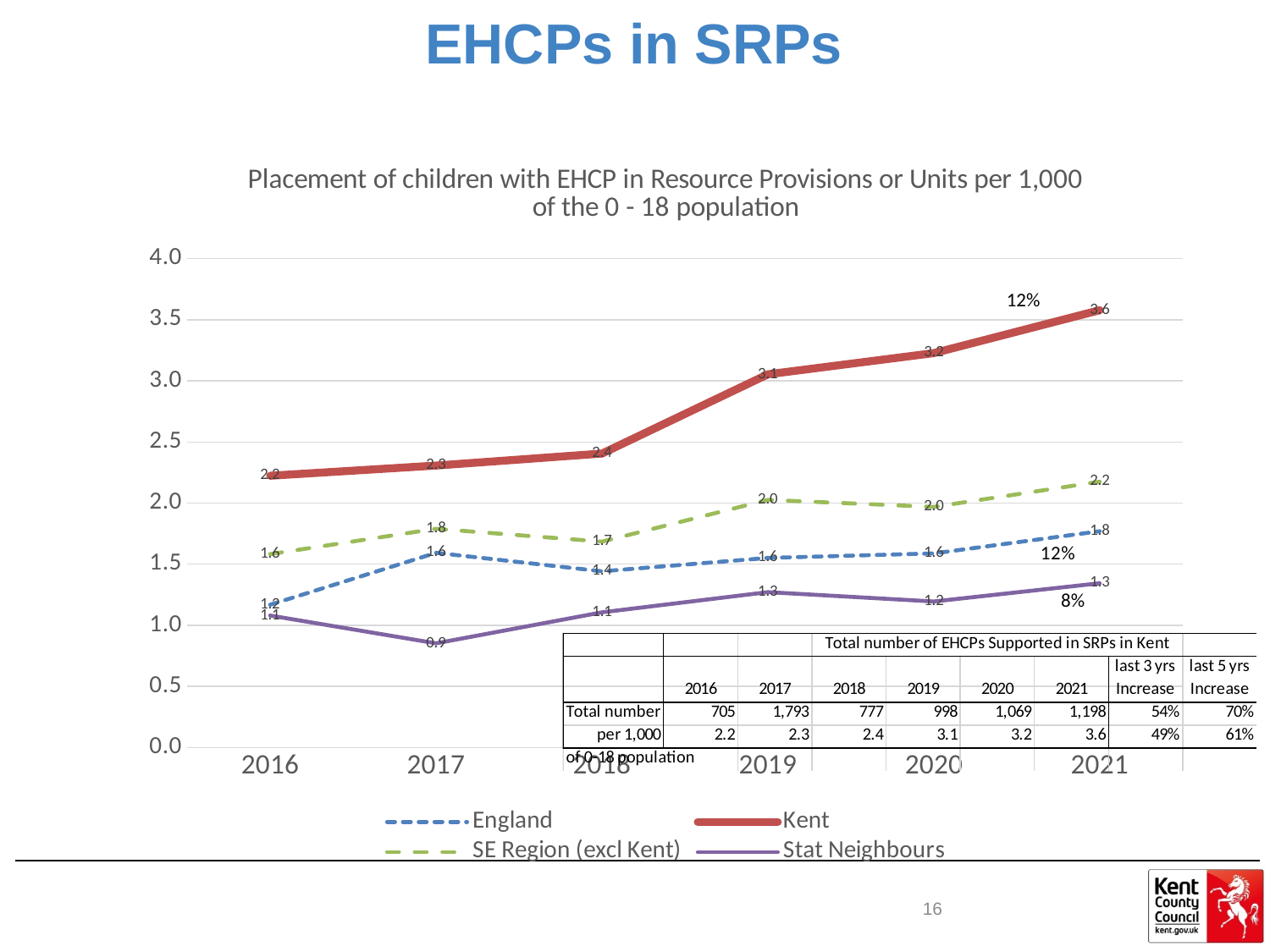
In which year is the Kent value highest? 2021 What is the value for England in 2016? 1.2 Does the Kent line rise or fall from 2016 to 2021? rise What is the value for SE Region (excl Kent) in 2019? 2.0 What is the value for Kent in 2021? 3.6 What is the difference between the Kent value and the England value in 2021? 1.8 Which series has the higher value in 2019, Kent or SE Region (excl Kent)? Kent What type of chart is shown on the slide? line chart In which year is the Stat Neighbours value lowest? 2017 How many years are plotted on the x axis? 6 How many series does the chart legend list? 4 What is the value for Stat Neighbours in 2017? 0.9